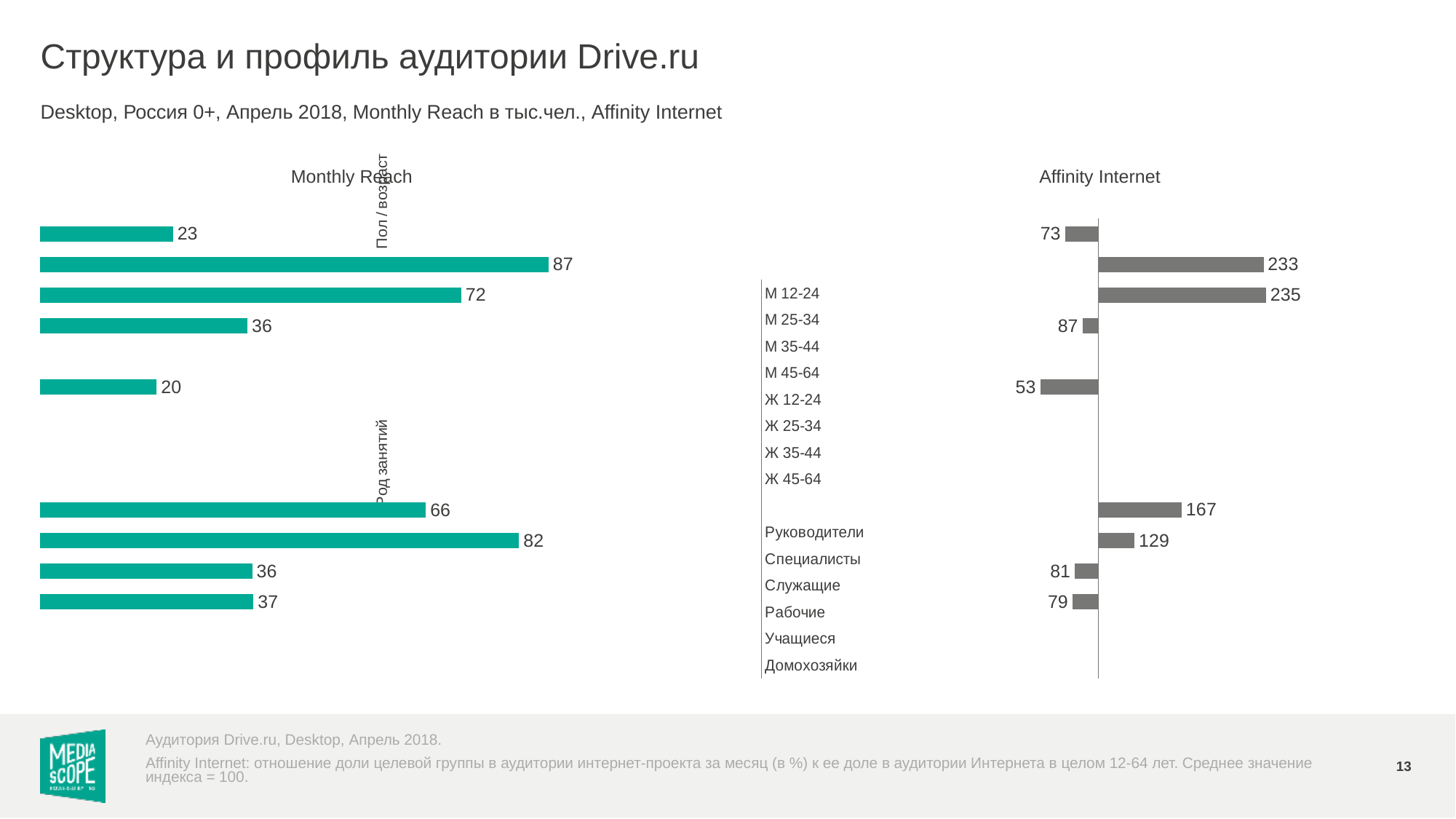
In the Affinity Internet chart, what is the value of the topmost bar? 73 How many bars are plotted in the Monthly Reach chart? 9 In the Affinity Internet chart, what is the lowest value shown? 53 What colour are the bars in the Affinity Internet chart? grey In the Monthly Reach chart, what is the difference between the highest value (87) and the lowest value (20)? 67 In the Affinity Internet chart, what is the highest value shown? 235 What kind of chart is the Monthly Reach chart? bar chart In the Affinity Internet chart, how many bars are plotted in the lower (Род занятий) section? 4 In the Monthly Reach chart, what is the highest value shown? 87 In the Affinity Internet chart, what is the difference between the two largest values, 235 and 233? 2 In the Monthly Reach chart, what is the lowest value shown? 20 In the Monthly Reach chart, what is the value of the topmost bar? 23